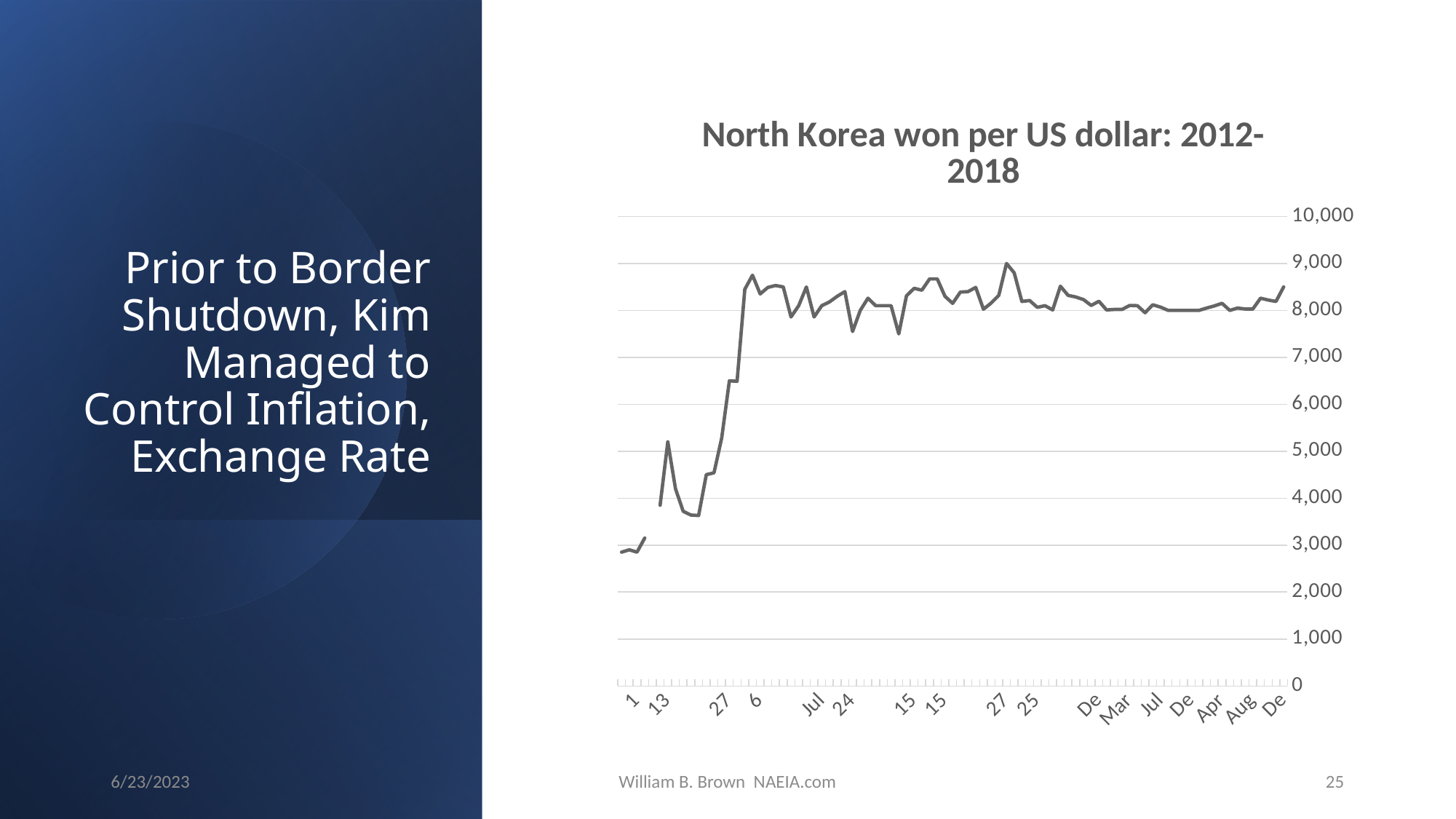
Overall, does the won per US dollar rise or fall from the left of the chart to the right? rise Is the value at the last point on the right (labelled De) greater or less than 8,000? greater Which is larger, the value at the point labelled 1 or the value at the first point labelled Jul? Jul Is the value at the first point on the left (labelled 1) greater or less than 4,000? less What is the highest value shown on the vertical axis? 10,000 Is the highest point on the line greater or less than 8,000? greater What kind of chart is shown on the slide? line chart How many lines are plotted on the chart? 1 What is the title of the chart? North Korea won per US dollar: 2012-2018